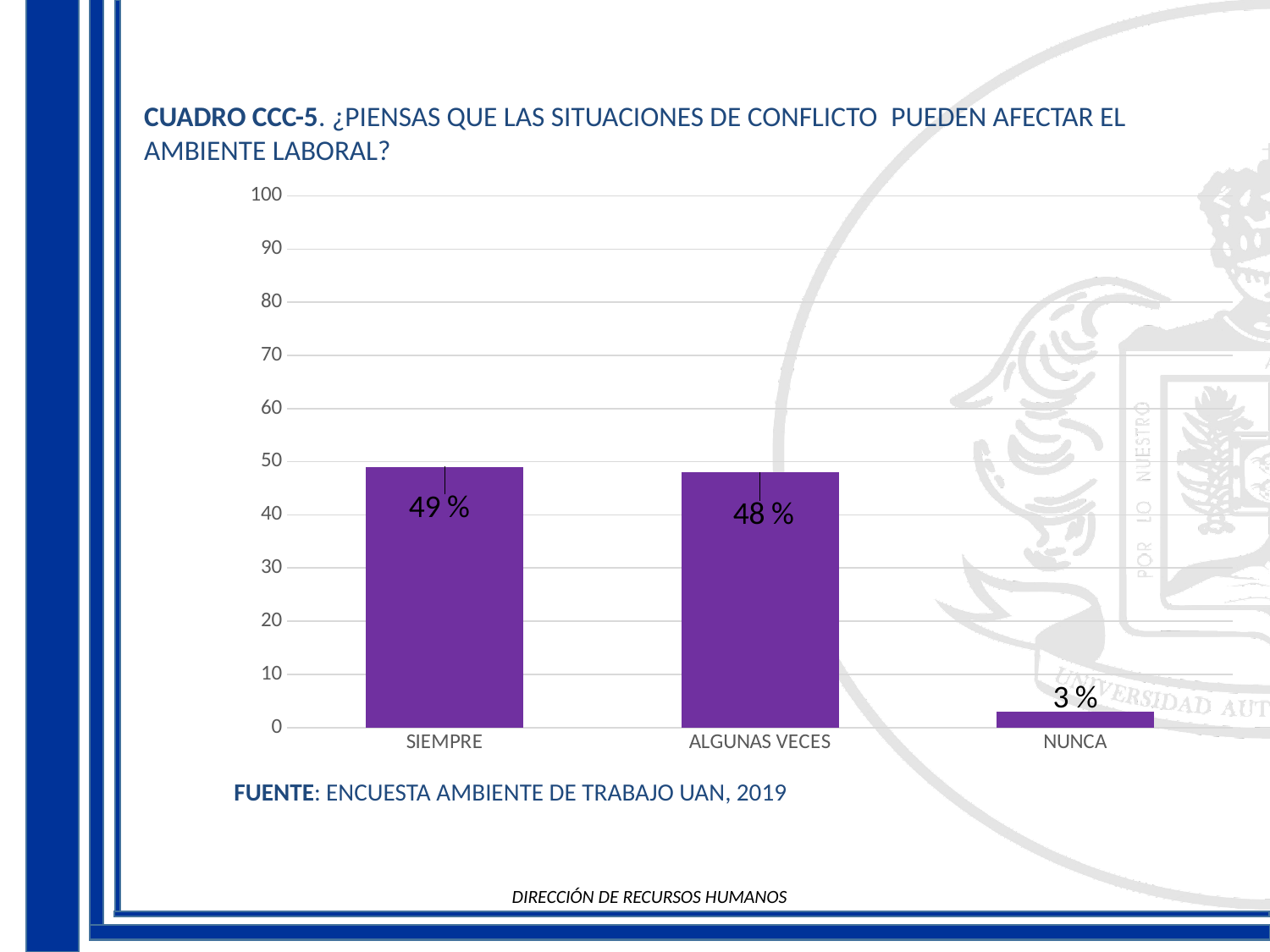
Which category has the lowest value? NUNCA What source is cited below the chart? ENCUESTA AMBIENTE DE TRABAJO UAN, 2019 What is the value for SIEMPRE? 49 % Which category has the highest value? SIEMPRE Is the value for NUNCA greater or less than 10? less What is the difference between the values for SIEMPRE and NUNCA? 46 % What kind of chart is shown on the slide? bar chart What is the value for NUNCA? 3 % What is the difference between the values for ALGUNAS VECES and NUNCA? 45 % What is the value for ALGUNAS VECES? 48 % How many categories are shown on the x axis? 3 Which is larger, the value for ALGUNAS VECES or the value for NUNCA? ALGUNAS VECES